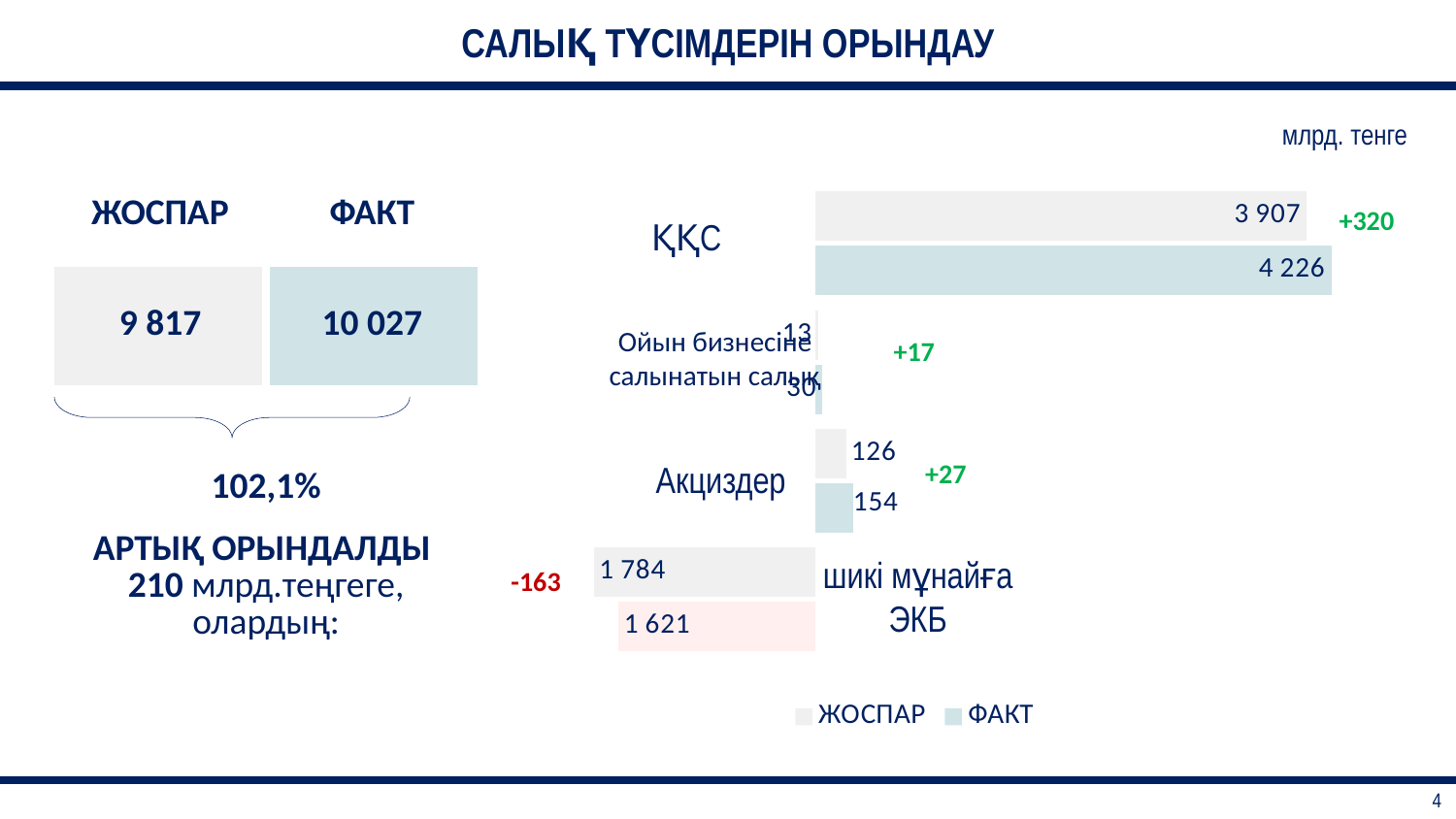
What is the ФАКТ value for ҚҚС? 4 226 What is the ЖОСПАР value for шикі мұнайға ЭКБ? 1 784 What is the ЖОСПАР value for ҚҚС? 3 907 What is the ФАКТ value for Акциздер? 154 What is the ФАКТ value for шикі мұнайға ЭКБ? 1 621 Which category has the lowest ЖОСПАР value? Ойын бизнесіне салынатын салық What is the difference between the ФАКТ and ЖОСПАР values for Акциздер? 28 For шикі мұнайға ЭКБ, which is larger: ЖОСПАР or ФАКТ? ЖОСПАР How many series does the legend list? 2 How many categories does the chart show? 4 Which category has the highest ФАКТ value? ҚҚС What kind of chart is shown on the slide? bar chart